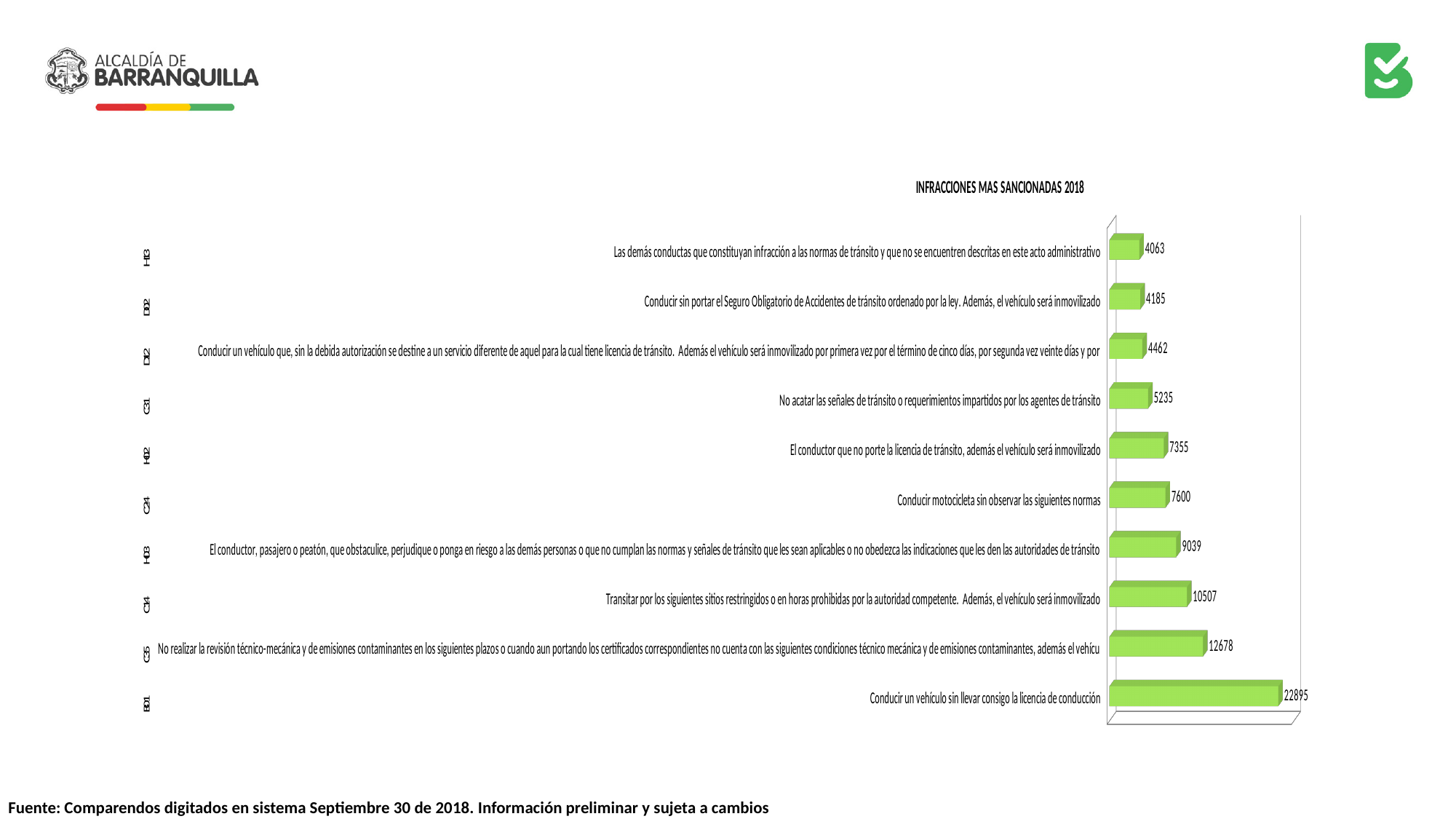
Which is larger: the value for "El conductor que no porte la licencia de tránsito" or the value for "Conducir motocicleta sin observar las siguientes normas"? Conducir motocicleta sin observar las siguientes normas What is the difference between the value for "Conducir un vehículo sin llevar consigo la licencia de conducción" (22895) and the value for "No realizar la revisión técnico-mecánica..." (12678)? 10217 How many categories (infractions) are plotted in the chart? 10 What is the value for "Conducir motocicleta sin observar las siguientes normas"? 7600 What is the value for "Transitar por los siguientes sitios restringidos o en horas prohibidas por la autoridad competente"? 10507 Which infraction has the lowest value in the chart? Las demás conductas que constituyan infracción a las normas de tránsito y que no se encuentren descritas en este acto administrativo Which infraction has the highest value in the chart? Conducir un vehículo sin llevar consigo la licencia de conducción What kind of chart is shown on the slide? Bar chart What is the value for "No acatar las señales de tránsito o requerimientos impartidos por los agentes de tránsito"? 5235 What is the title of the chart? INFRACCIONES MAS SANCIONADAS 2018 What is the difference between the value for "Conducir sin portar el Seguro Obligatorio de Accidentes de tránsito" (4185) and "Las demás conductas que constituyan infracción..." (4063)? 122 What is the value for "Conducir un vehículo sin llevar consigo la licencia de conducción"? 22895